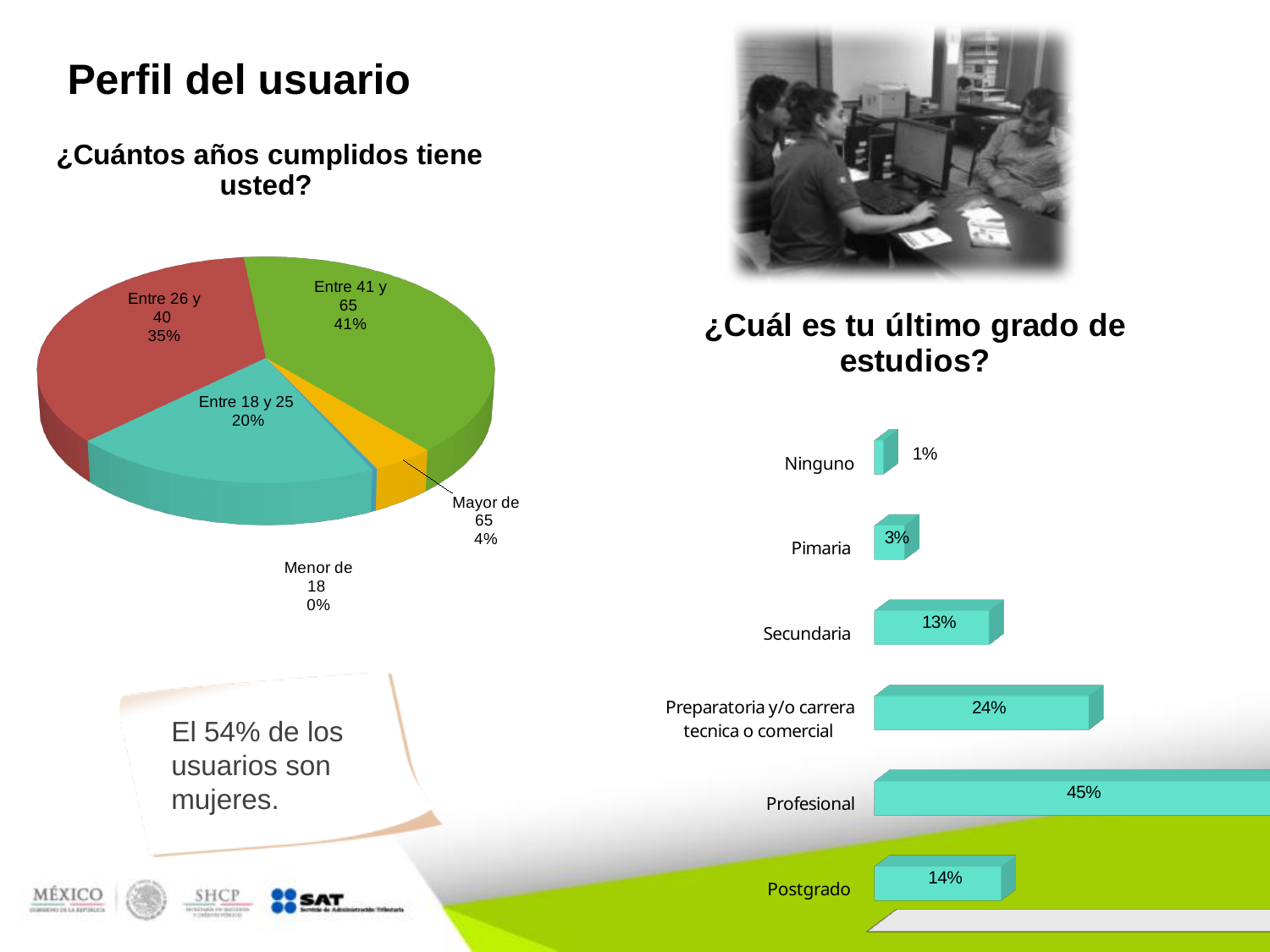
In the bar chart '¿Cuál es tu último grado de estudios?', which is larger: 'Secundaria' or 'Preparatoria y/o carrera tecnica o comercial'? Preparatoria y/o carrera tecnica o comercial In the bar chart '¿Cuál es tu último grado de estudios?', what percentage is shown for 'Profesional'? 45% In the pie chart '¿Cuántos años cumplidos tiene usted?', what is the difference in percentage points between 'Entre 26 y 40' and 'Mayor de 65'? 31 What type of chart is used for '¿Cuál es tu último grado de estudios?'? Bar chart In the bar chart '¿Cuál es tu último grado de estudios?', which category has the lowest value? Ninguno In the pie chart '¿Cuántos años cumplidos tiene usted?', what percentage is shown for 'Entre 18 y 25'? 20% In the bar chart '¿Cuál es tu último grado de estudios?', what percentage is shown for 'Postgrado'? 14% In the pie chart '¿Cuántos años cumplidos tiene usted?', which age group has the largest share? Entre 41 y 65 In the pie chart '¿Cuántos años cumplidos tiene usted?', how many age categories are shown? 5 What type of chart is used for '¿Cuántos años cumplidos tiene usted?'? Pie chart In the pie chart '¿Cuántos años cumplidos tiene usted?', which age group has the smallest share? Menor de 18 In the pie chart '¿Cuántos años cumplidos tiene usted?', what percentage is shown for 'Entre 41 y 65'? 41%